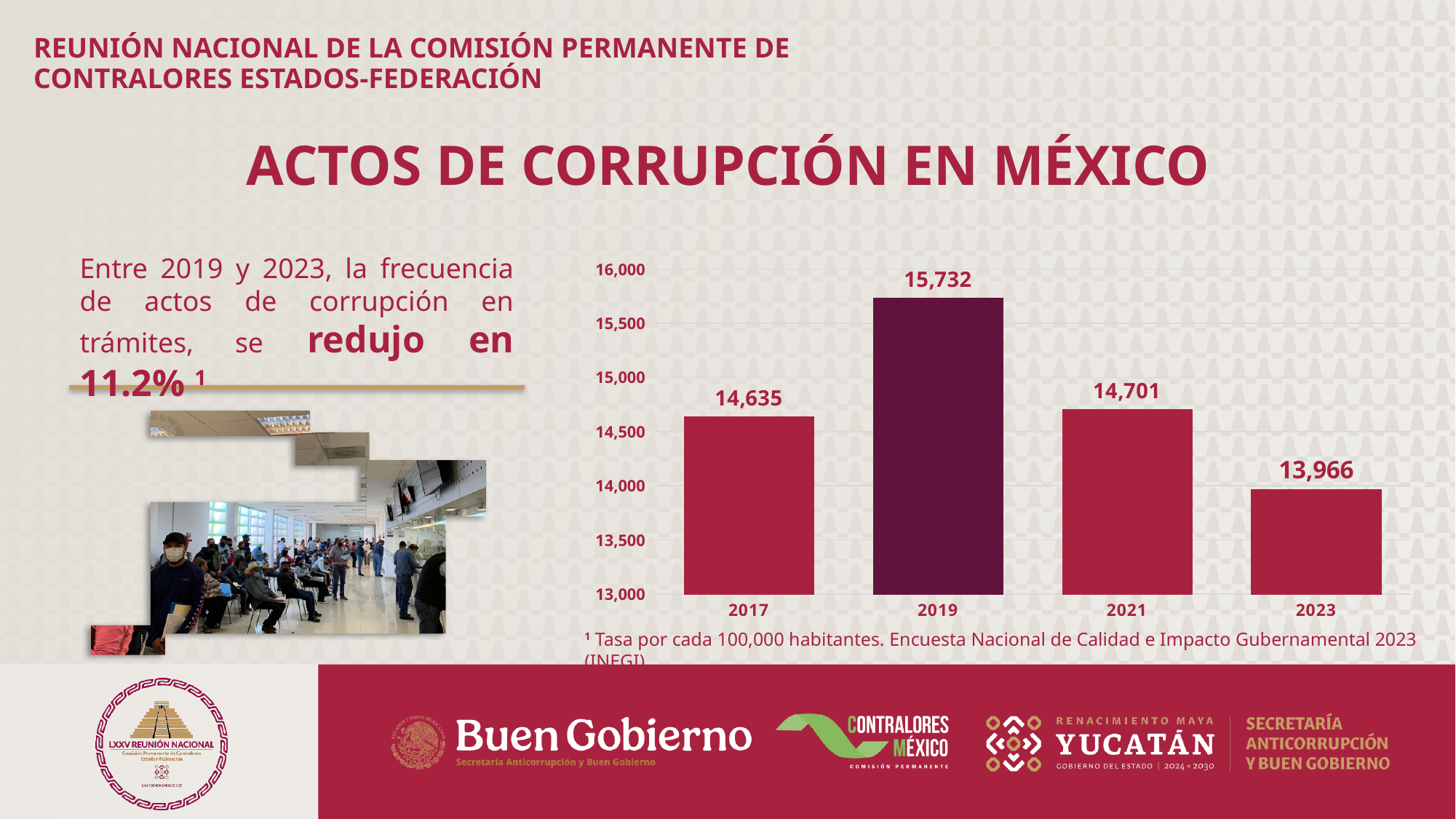
Which is larger, the value for 2017 or the value for 2021? 2021 What is the value for 2021? 14,701 Which year has the highest value? 2019 What is the value for 2019? 15,732 Do the values rise or fall from 2019 to 2023? fall Is the value for 2023 greater or less than 14,000? less What is the value for 2023? 13,966 Which year has the lowest value? 2023 What is the difference between the values for 2019 and 2023? 1,766 What is the value for 2017? 14,635 How many years are shown on the x axis? 4 What kind of chart is shown on the slide? bar chart